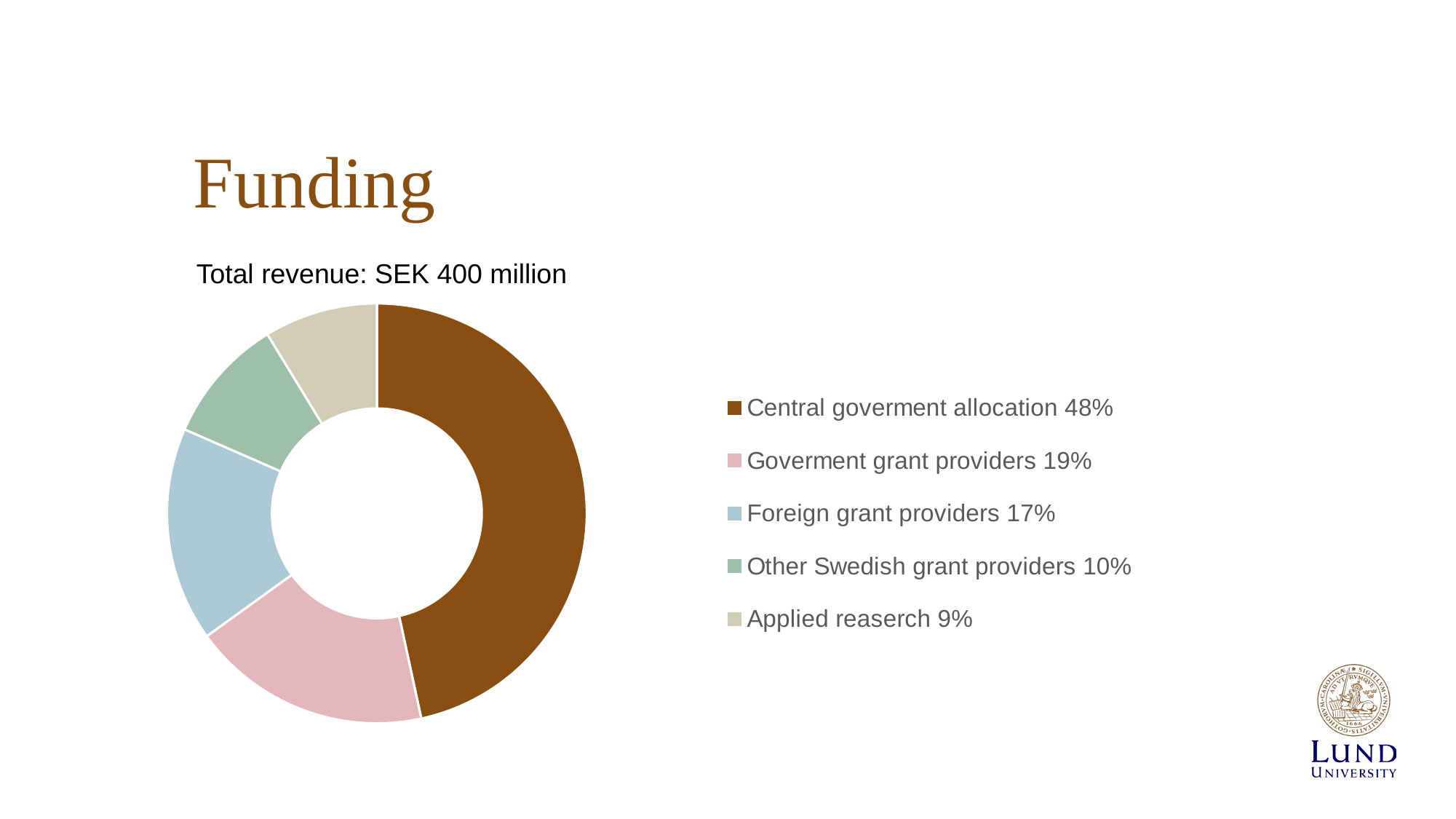
What share of funding comes from Applied reaserch? 9% Which is larger: the share for Goverment grant providers or Foreign grant providers? Goverment grant providers What is the combined share of Other Swedish grant providers and Applied reaserch? 19% What share of funding comes from Central goverment allocation? 48% What kind of chart is shown on the slide? Doughnut (pie) chart How many funding categories are shown in the chart? 5 What colour represents Foreign grant providers in the chart? Light blue Which funding source has the largest share? Central goverment allocation What total revenue is stated above the chart? SEK 400 million What is the difference in share between Central goverment allocation and Goverment grant providers? 29 percentage points Which funding source has the smallest share? Applied reaserch What share of funding comes from Foreign grant providers? 17%